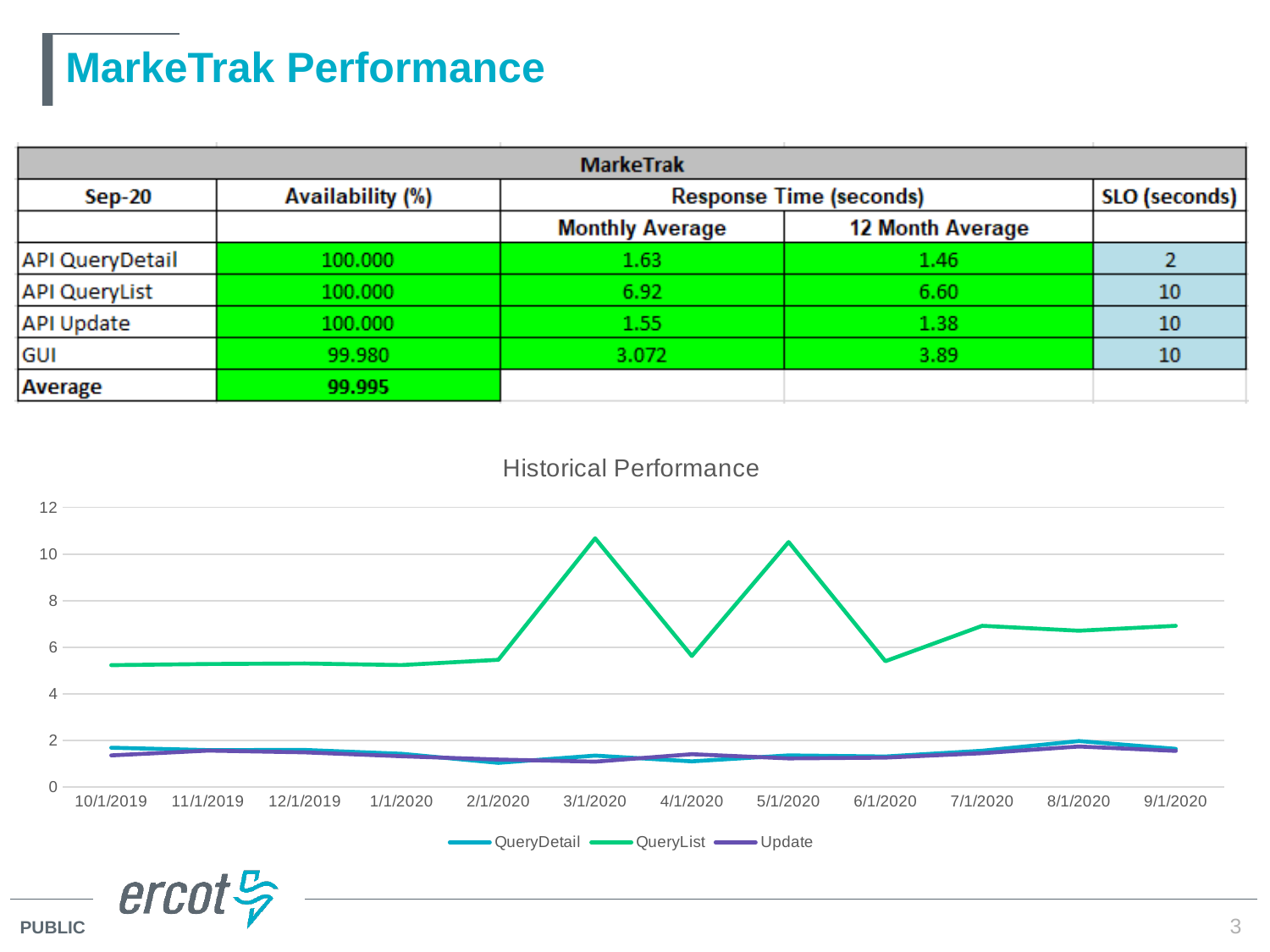
How many dates are shown on the x axis of the Historical Performance chart? 12 Which series has the highest values throughout the Historical Performance chart? QueryList In the Historical Performance chart, is the QueryList value for 6/1/2020 greater or less than 8? less What is the title of the line chart on the slide? Historical Performance In the Historical Performance chart, which series has the larger value at 6/1/2020, QueryList or Update? QueryList What kind of chart is the Historical Performance chart? line chart In the Historical Performance chart, is the QueryList value for 3/1/2020 greater or less than 10? greater In the Historical Performance chart, is the QueryList value larger at 3/1/2020 or at 4/1/2020? 3/1/2020 In the Historical Performance chart, is the QueryDetail value for 9/1/2020 greater or less than 2? less In the Historical Performance chart, does the QueryList line rise or fall from 5/1/2020 to 6/1/2020? fall How many series does the legend of the Historical Performance chart list? 3